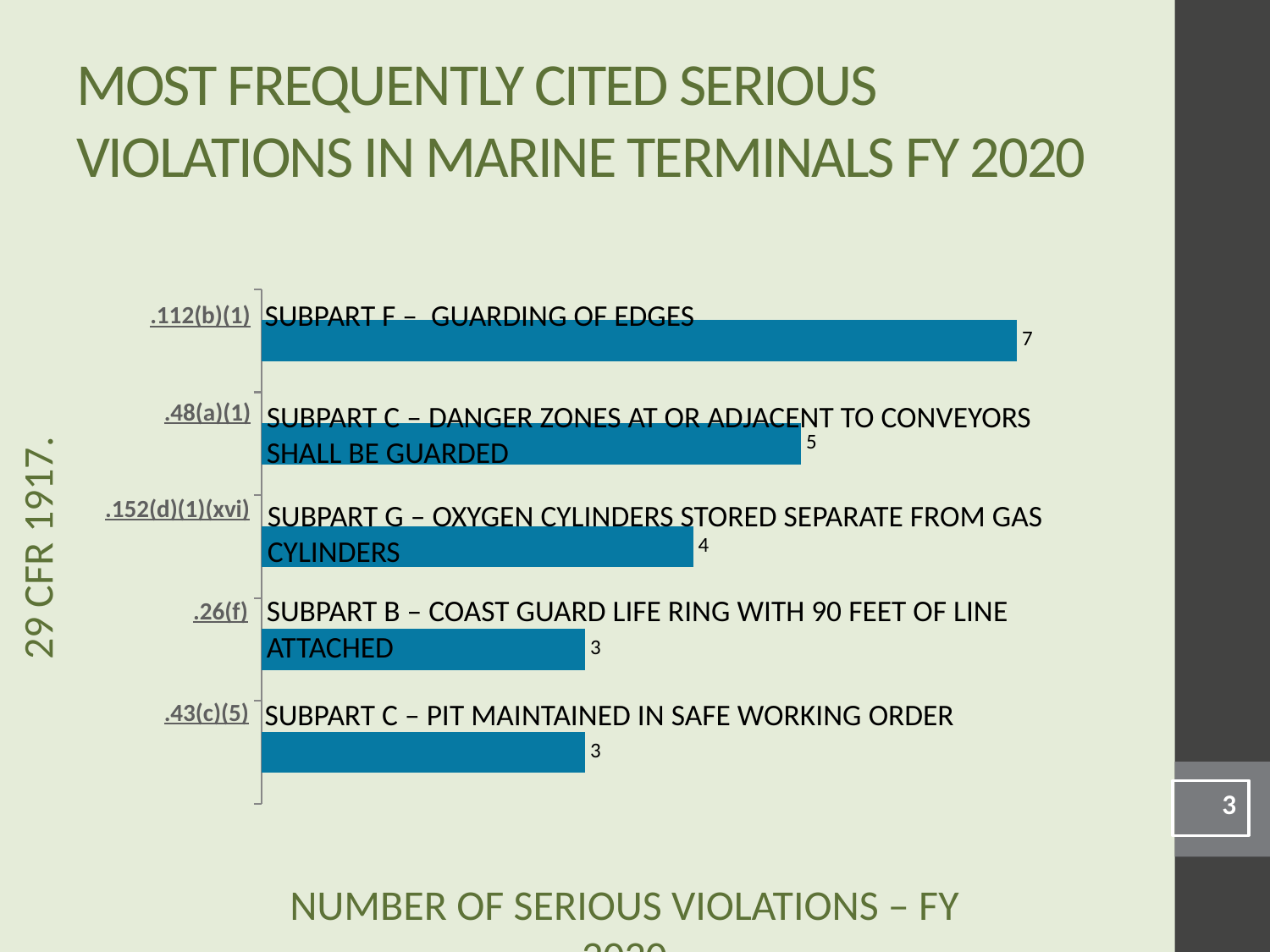
What label appears along the vertical axis of the chart? 29 CFR 1917. What is the number of serious violations for .48(a)(1) (Subpart C – Danger zones at or adjacent to conveyors shall be guarded)? 5 What is the total number of serious violations across all five standards shown? 22 Which standard has the highest number of serious violations? .112(b)(1) What is the number of serious violations for .26(f) (Subpart B – Coast Guard life ring with 90 feet of line attached)? 3 What is the difference between the number of violations for .48(a)(1) and .26(f)? 2 Which has more serious violations, .152(d)(1)(xvi) or .43(c)(5)? .152(d)(1)(xvi) What is the difference between the number of violations for .112(b)(1) and .48(a)(1)? 2 What is the number of serious violations for .112(b)(1) (Subpart F – Guarding of Edges)? 7 What is the number of serious violations for .152(d)(1)(xvi) (Subpart G – Oxygen cylinders stored separate from gas cylinders)? 4 What kind of chart is shown on the slide? Bar chart How many standards (categories) are shown in the chart? 5